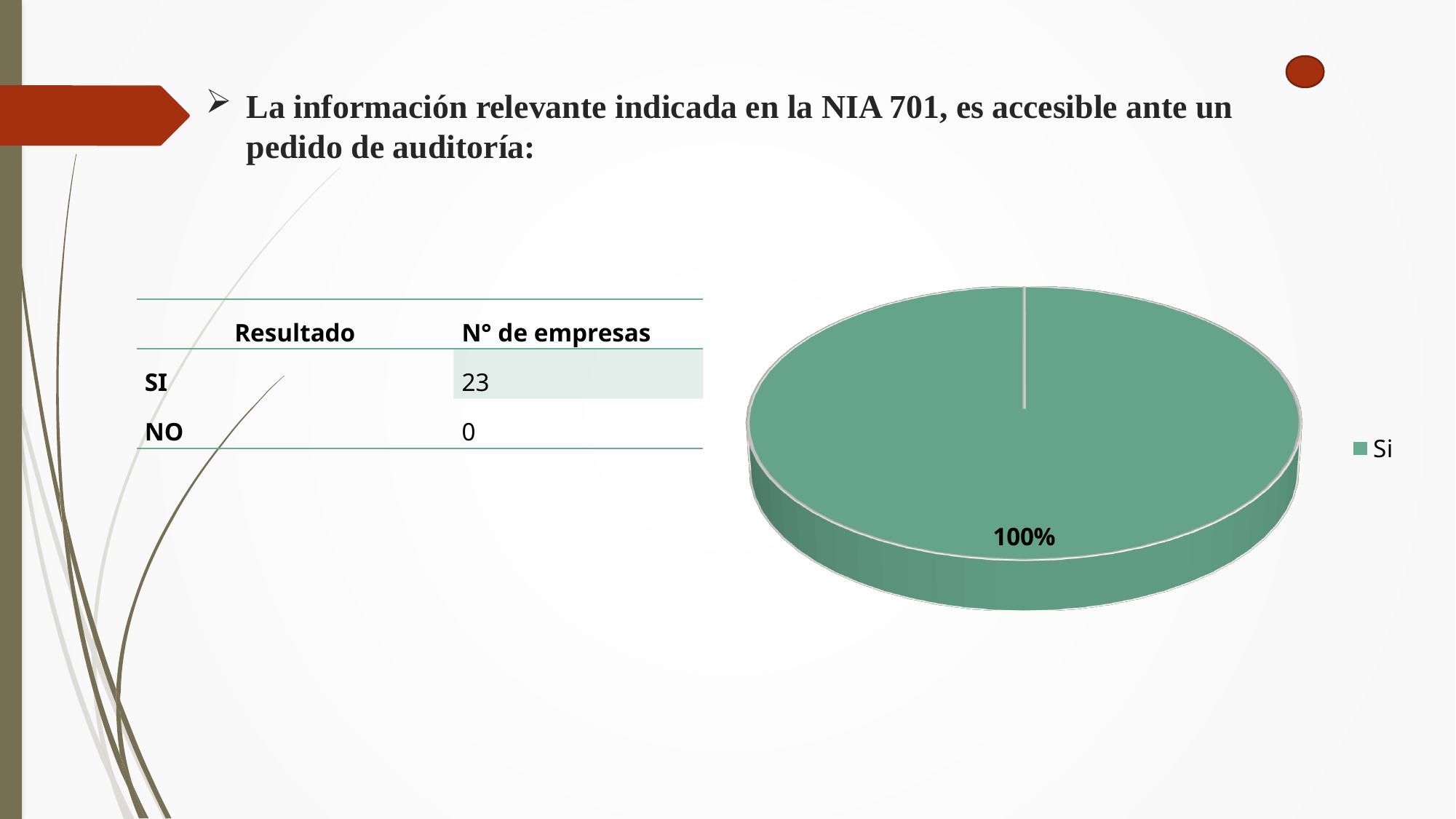
Is the share shown for "Si" in the pie chart greater or less than 50%? greater What kind of chart is shown on the slide? pie chart What data label is printed on the pie chart? 100% Which category occupies the largest share of the pie chart? Si How many slices are visible in the pie chart? 1 How many entries does the pie chart's legend list? 1 What colour is the "Si" slice in the pie chart? green What share of the pie chart does the "Si" slice represent? 100% What is the label of the only entry in the pie chart's legend? Si